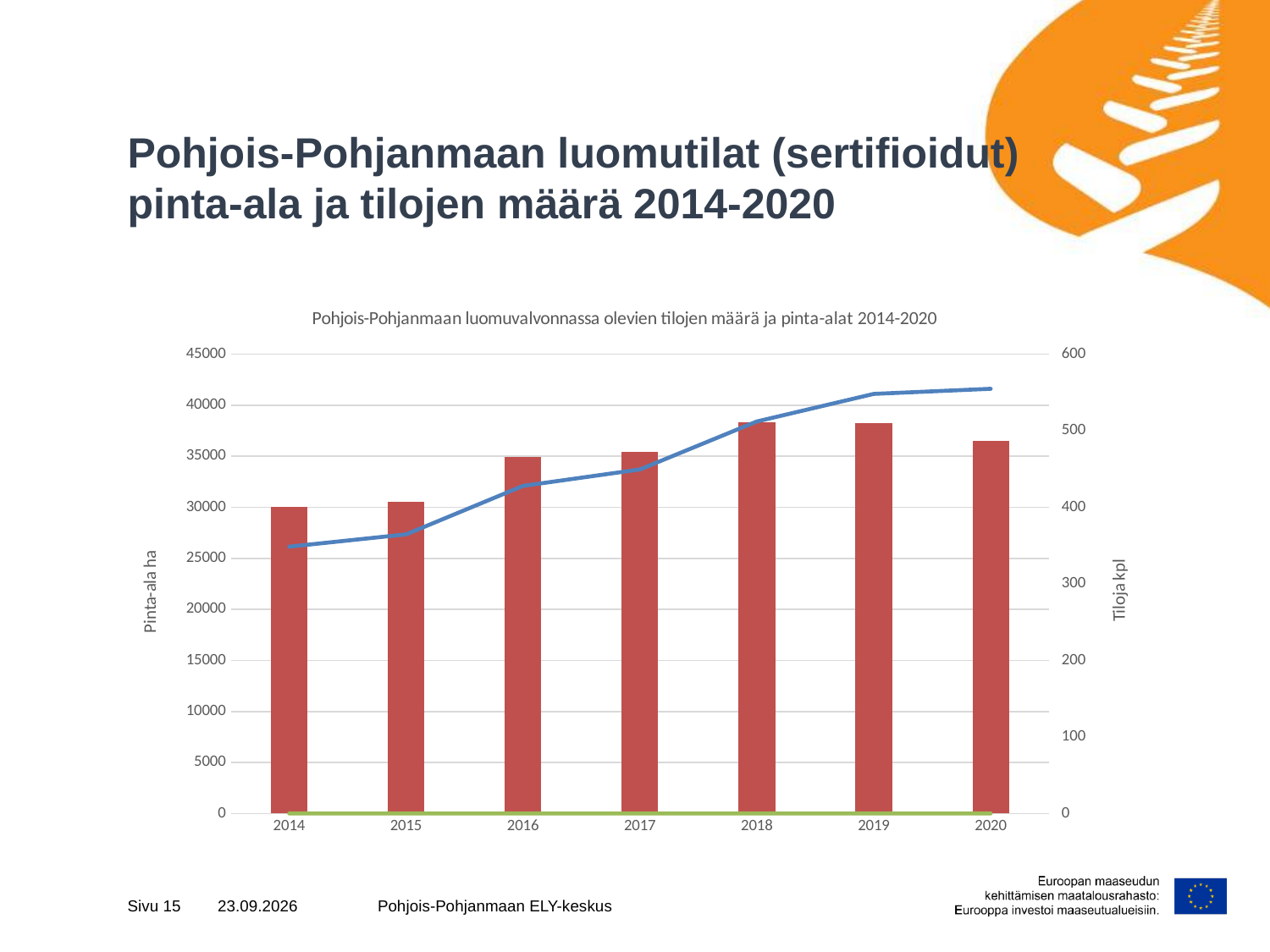
Is the bar value for 2016 greater or less than 40000? less What kind of chart is shown on the slide? A bar chart combined with a line Is the line value for 2014 on the right axis greater or less than 400? less What is the title of the chart? Pohjois-Pohjanmaan luomuvalvonnassa olevien tilojen määrä ja pinta-alat 2014-2020 Does the line rise or fall from 2014 to 2020? rise Which year has a taller bar, 2014 or 2016? 2016 Is the bar value for 2018 greater or less than 35000? greater How many years are shown on the x axis of the chart? 7 Which year has the lowest value on the line? 2014 What is the label of the left vertical axis? Pinta-ala ha